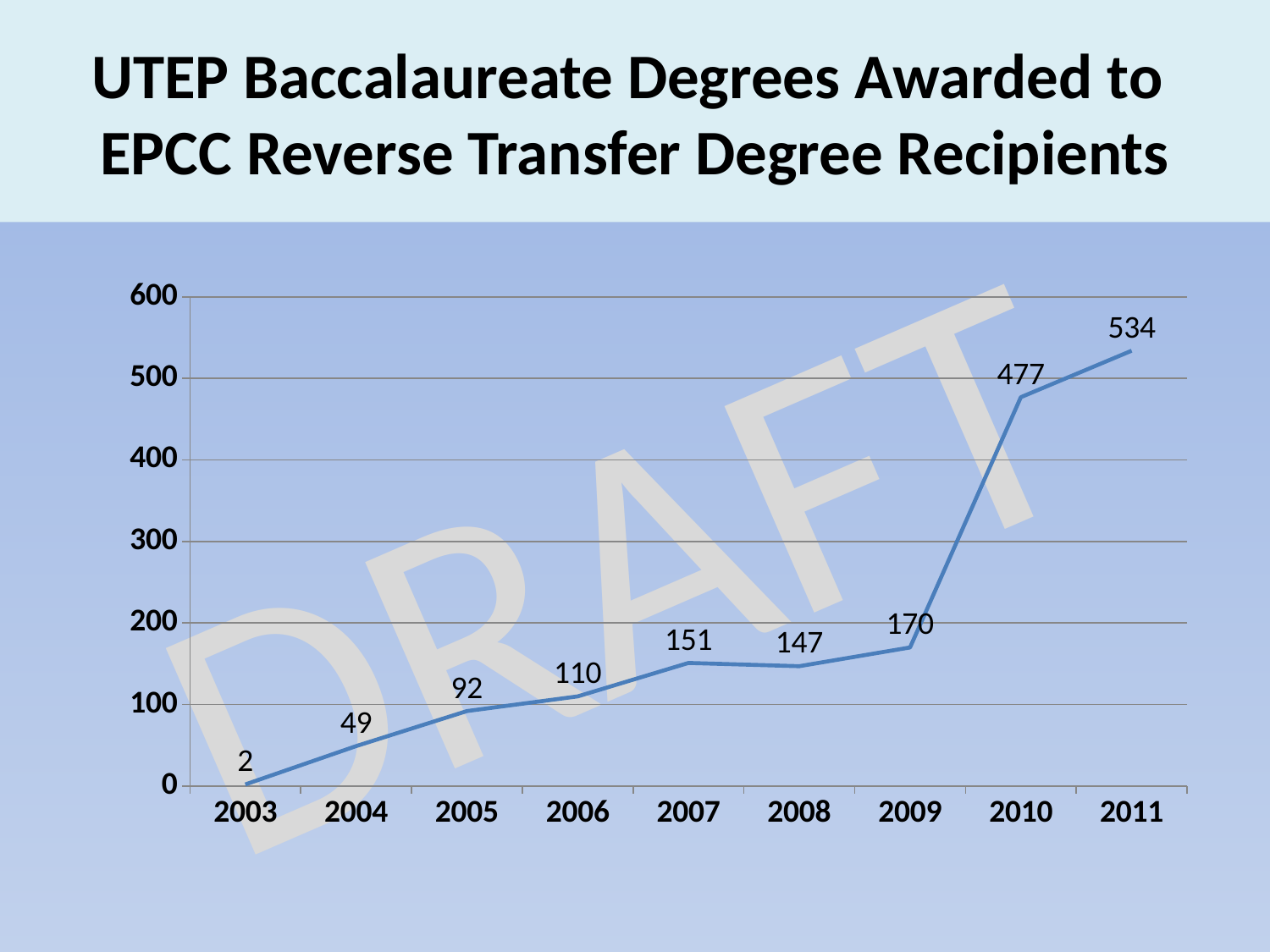
What kind of chart is shown on the slide? line chart Which year has the highest value? 2011 What is the title of the chart on the slide? UTEP Baccalaureate Degrees Awarded to EPCC Reverse Transfer Degree Recipients Do the values generally rise or fall from 2003 to 2011? rise What is the value for 2007? 151 What is the difference between the values for 2009 and 2008? 23 What is the value for 2003? 2 How many years are plotted on the x axis? 9 Which year has the lowest value? 2003 What is the difference between the values for 2011 and 2010? 57 What is the value for 2010? 477 Which is larger, the value for 2007 or the value for 2008? 2007